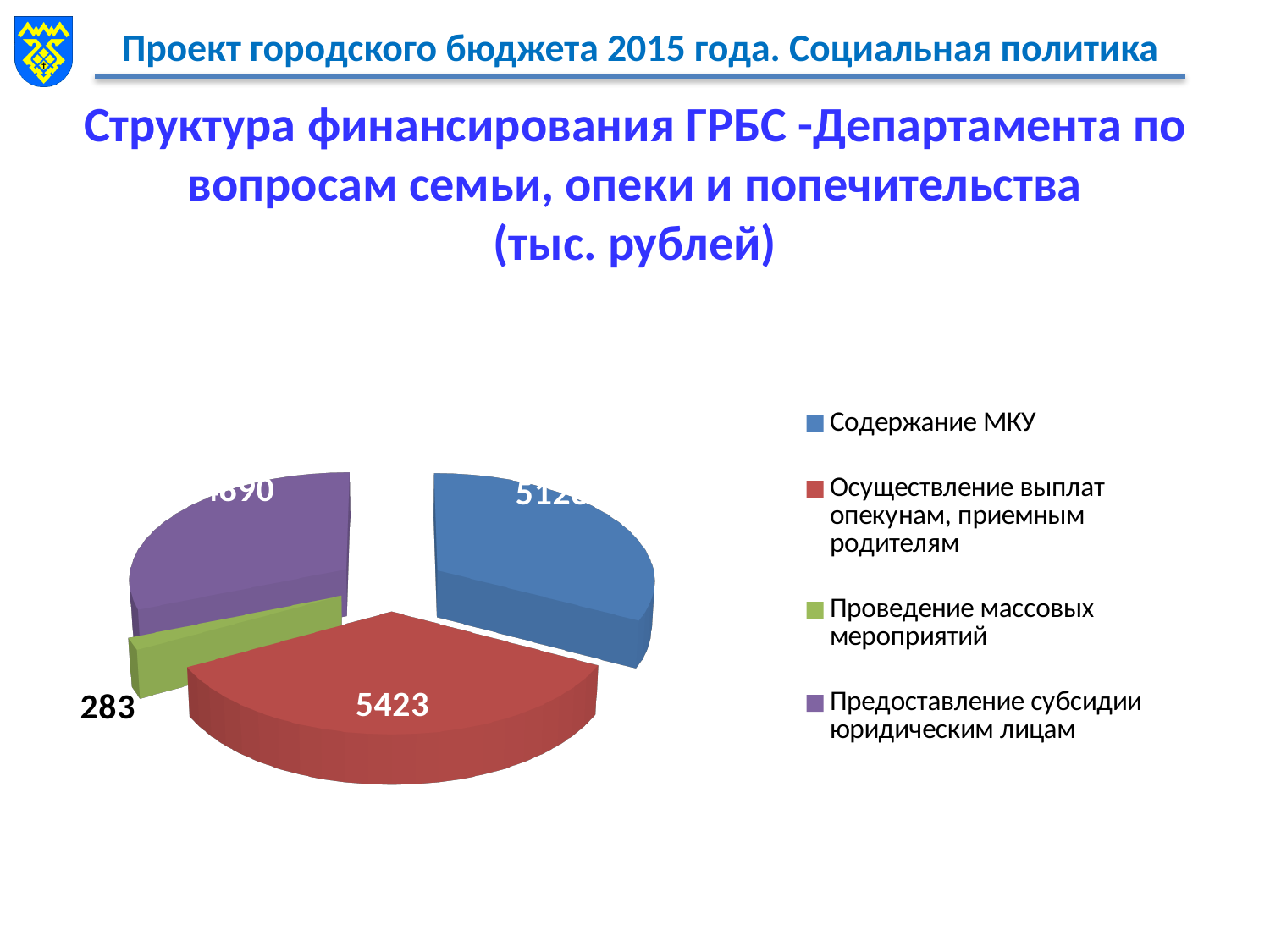
How many entries does the legend list? 4 How many slices does the pie chart have? 4 Which is larger: the value for Содержание МКУ or the value for Проведение массовых мероприятий? Содержание МКУ What is the value for Осуществление выплат опекунам, приемным родителям? 5423 Which is larger: the value for Предоставление субсидии юридическим лицам or the value for Проведение массовых мероприятий? Предоставление субсидии юридическим лицам Which category has the largest slice of the pie? Осуществление выплат опекунам, приемным родителям Which category has the smallest slice of the pie? Проведение массовых мероприятий What is the value for Проведение массовых мероприятий? 283 What is the difference between the values for Осуществление выплат опекунам, приемным родителям and Проведение массовых мероприятий? 5140 In what units are the values on the chart given, according to the slide title? тыс. рублей What kind of chart is shown on the slide? pie chart What colour is the slice for Содержание МКУ? blue